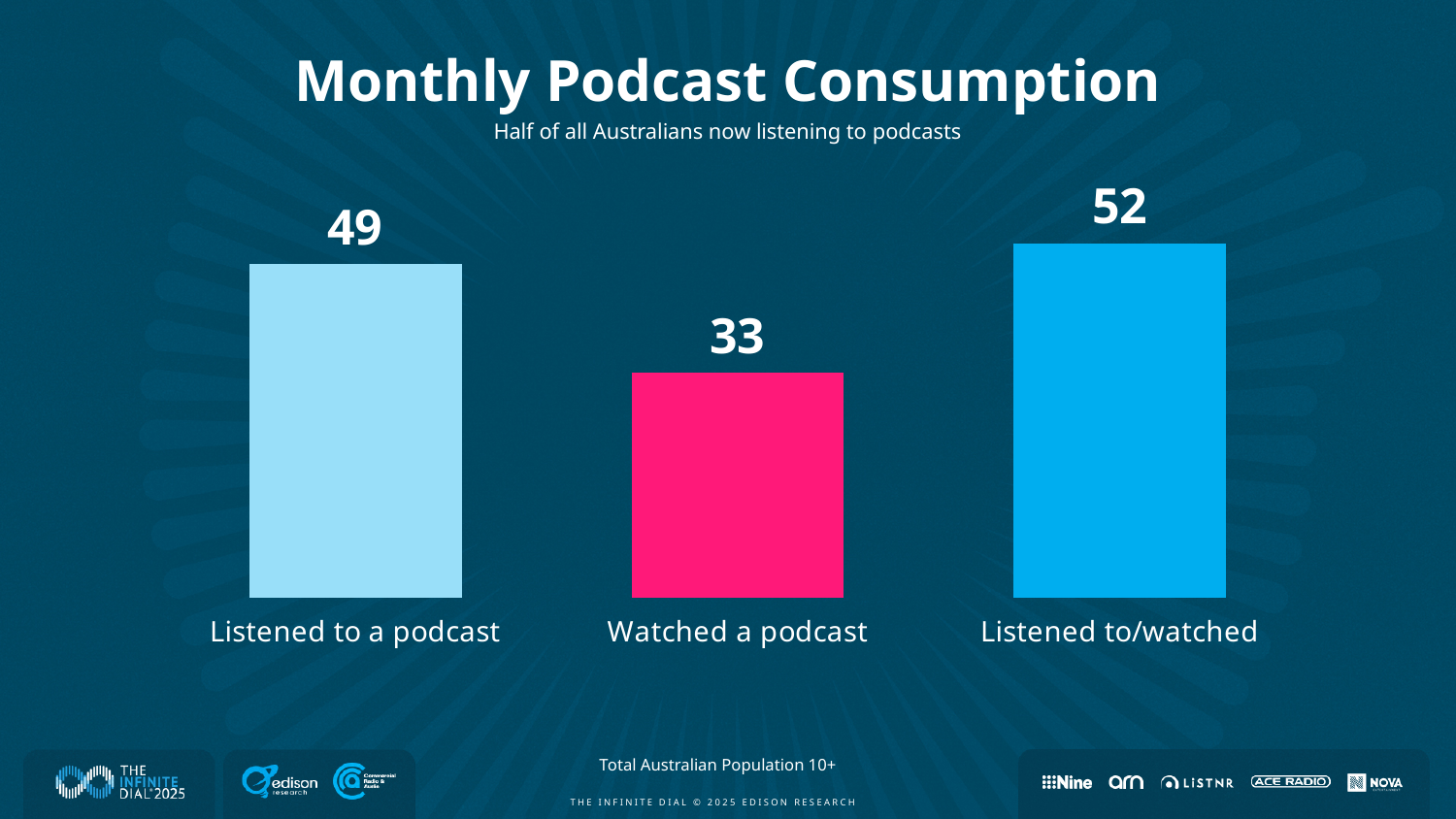
What is the value for "Listened to/watched"? 52 Which category has the highest value? Listened to/watched What is the value for "Watched a podcast"? 33 What is the value for "Listened to a podcast"? 49 Which category has the lowest value? Watched a podcast What is the difference between the values for "Listened to/watched" and "Watched a podcast"? 19 What kind of chart is shown on the slide? Bar chart Which is larger, the value for "Listened to a podcast" or "Watched a podcast"? Listened to a podcast How many categories are shown in the chart? 3 What is the difference between the values for "Listened to a podcast" and "Watched a podcast"? 16 What colour is the bar for "Watched a podcast"? Pink What is the title of the chart? Monthly Podcast Consumption